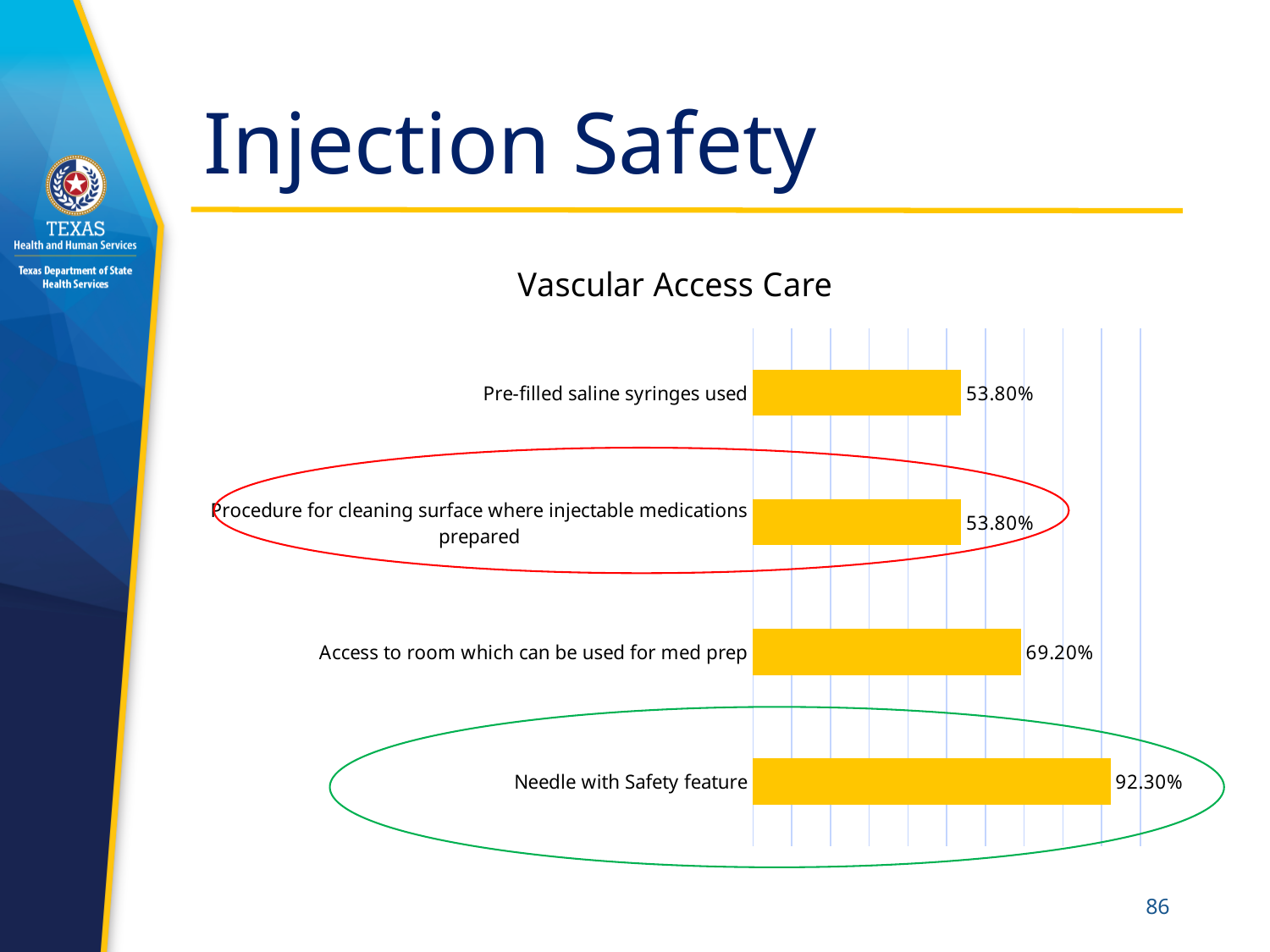
What is the difference between the values for Access to room which can be used for med prep and Pre-filled saline syringes used? 15.40% Which is larger, the value for Needle with Safety feature or the value for Pre-filled saline syringes used? Needle with Safety feature Which is larger, the value for Access to room which can be used for med prep or the value for Procedure for cleaning surface where injectable medications prepared? Access to room which can be used for med prep What is the value for Needle with Safety feature? 92.30% How many categories are shown in the chart? 4 What is the title of the chart? Vascular Access Care What is the difference between the values for Needle with Safety feature and Access to room which can be used for med prep? 23.10% Which category has the highest value? Needle with Safety feature What is the value for Pre-filled saline syringes used? 53.80% What kind of chart is shown on the slide? Bar chart What is the value for Procedure for cleaning surface where injectable medications prepared? 53.80% What is the value for Access to room which can be used for med prep? 69.20%